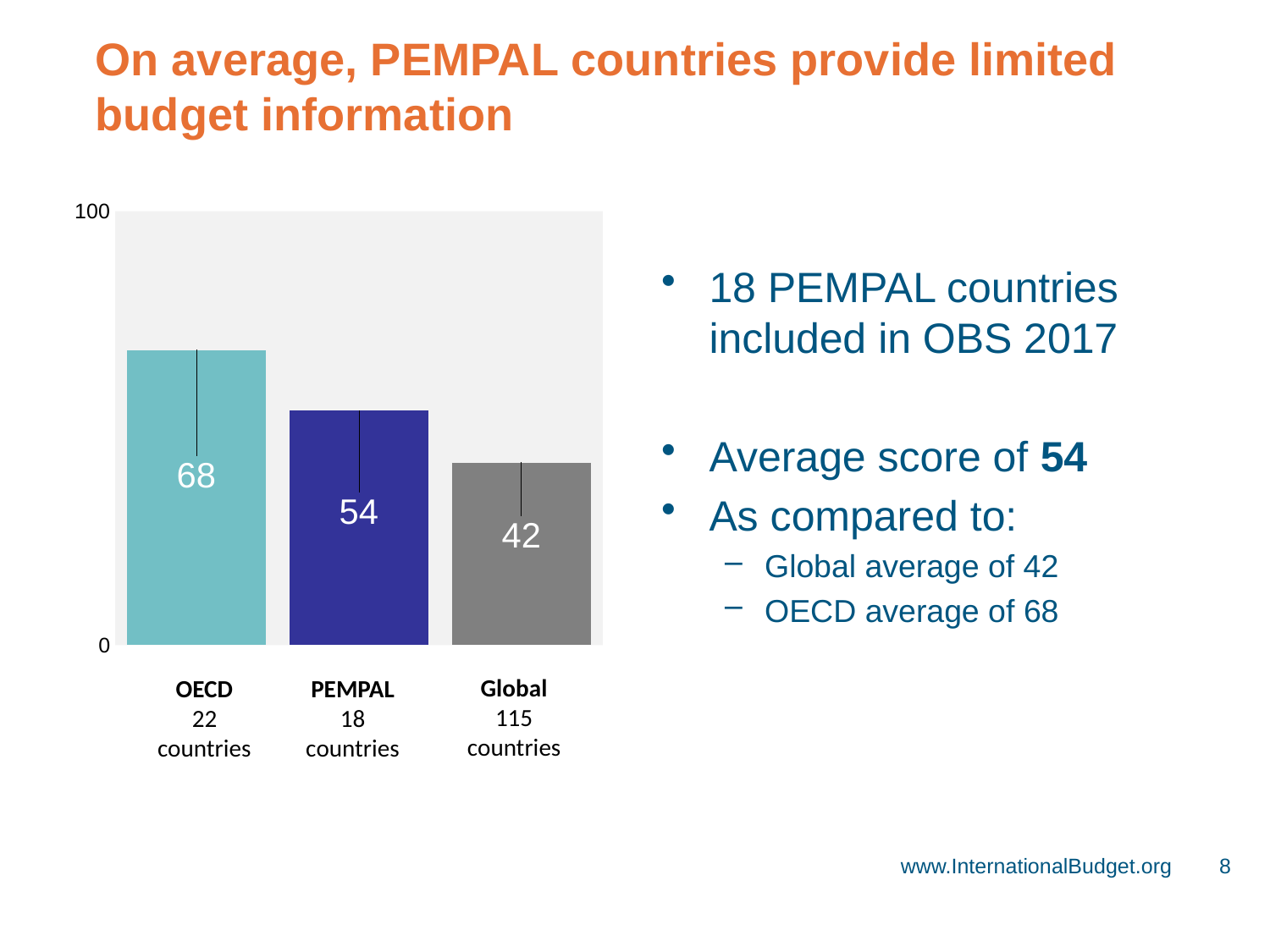
What is the value shown for Global? 42 What is the value shown for OECD? 68 Which category has the lowest value? Global How many countries are listed under the Global category label? 115 countries What is the difference between the OECD value and the PEMPAL value? 14 Do the values rise or fall from left to right across the categories? fall Which is larger, the value for PEMPAL or the value for Global? PEMPAL What kind of chart is shown on the slide? bar chart What is the difference between the PEMPAL value and the Global value? 12 How many categories are shown in the chart? 3 What is the value shown for PEMPAL? 54 Which category has the highest value? OECD